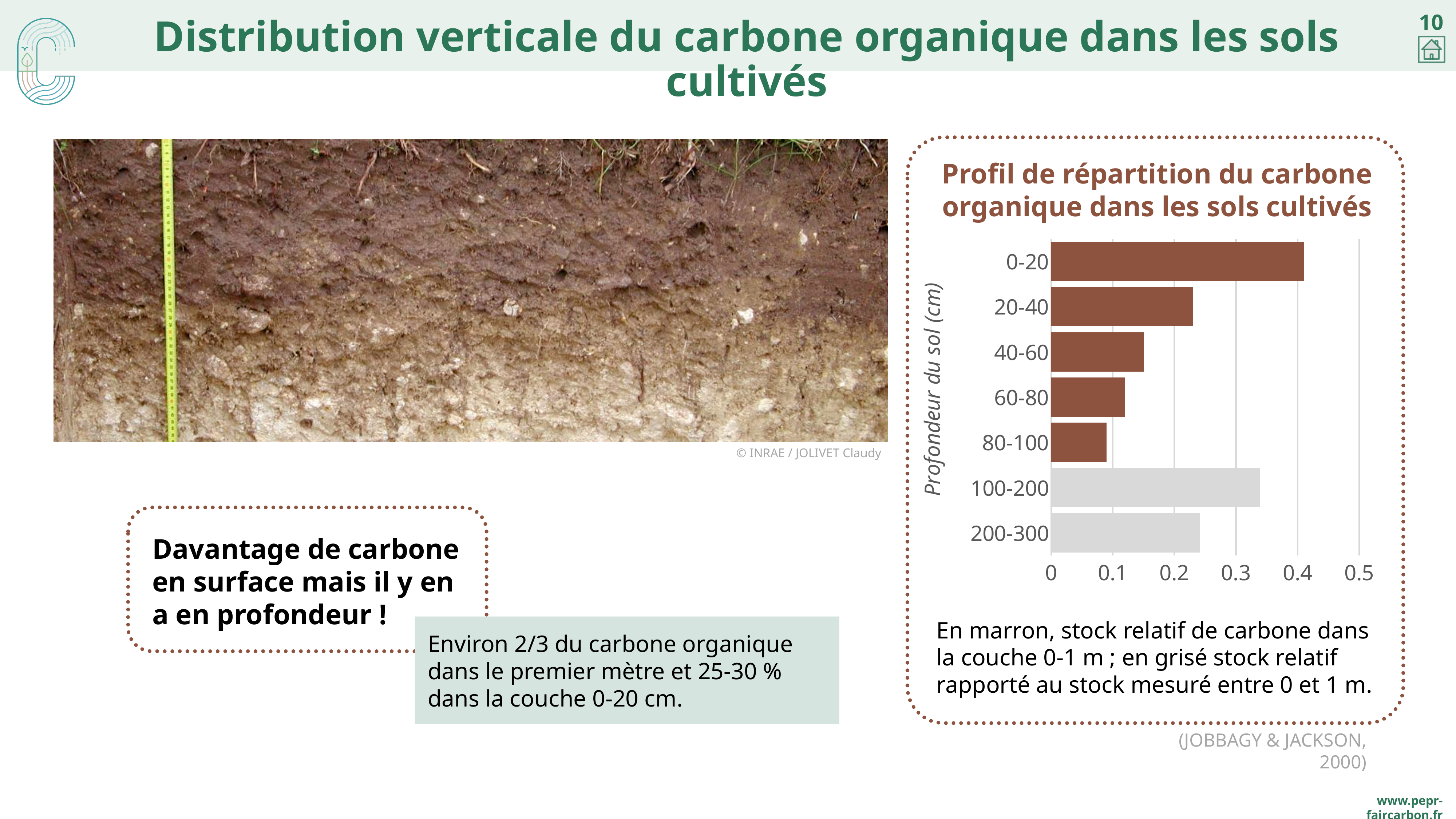
How many depth categories are plotted in the chart? 7 What is the title of the chart? Profil de répartition du carbone organique dans les sols cultivés Is the value for the 100-200 layer greater or less than 0.3? greater Among the brown bars (0-20 to 80-100), do the values rise or fall as depth increases? fall Is the value for the 40-60 layer greater or less than 0.2? less What type of chart is shown on the slide? Bar chart Is the value for the 60-80 layer greater or less than 0.2? less Which depth layer has the lowest value in the chart? 80-100 Which depth layer has the highest value in the chart? 0-20 Which has a larger value, the 0-20 layer or the 100-200 layer? 0-20 What is the label of the vertical axis of the chart? Profondeur du sol (cm)